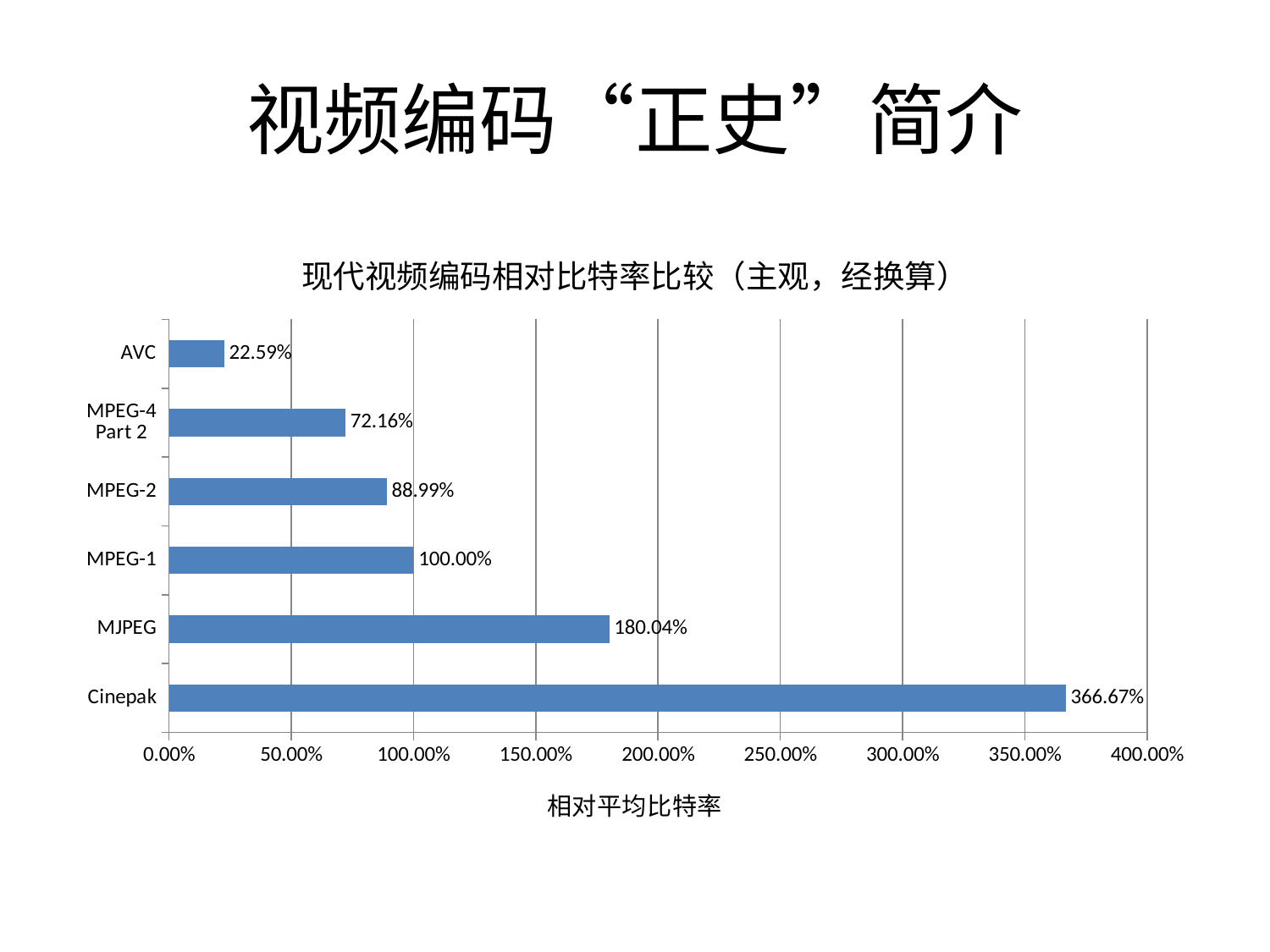
What is the x-axis title of the chart? 相对平均比特率 What is the value shown for MPEG-2? 88.99% What is the value shown for MJPEG? 180.04% What is the difference between the values for MPEG-1 and MPEG-4 Part 2? 27.84% What kind of chart is shown on the slide? Bar chart Which codec has the lowest relative average bitrate? AVC Which codec has the highest relative average bitrate? Cinepak What is the relative average bitrate value for AVC? 22.59% What is the difference between the values for Cinepak and MJPEG? 186.63% How many codecs are shown in the chart? 6 Which has a larger value, MPEG-2 or MPEG-4 Part 2? MPEG-2 Is the value for MJPEG greater or less than 150.00%? greater